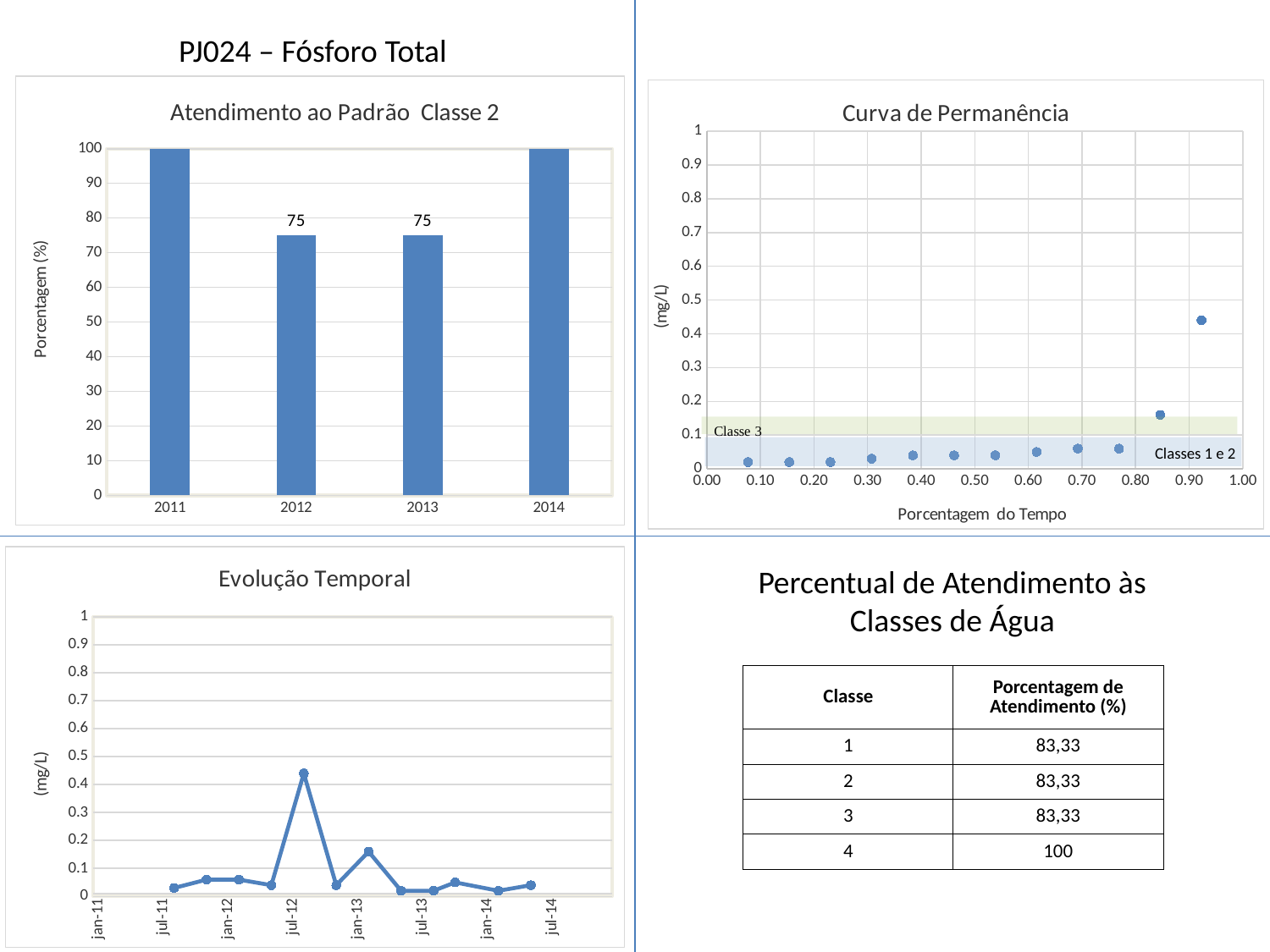
In the 'Atendimento ao Padrão Classe 2' chart, how many years are shown on the x axis? 4 In the 'Curva de Permanência' chart, is the highest plotted value greater or less than 0.4 mg/L? greater In the 'Atendimento ao Padrão Classe 2' chart, what is the difference between the values for 2014 and 2013? 25 In the 'Curva de Permanência' chart, how many data points are plotted? 12 What is the x-axis label of the 'Curva de Permanência' chart? Porcentagem do Tempo In the 'Atendimento ao Padrão Classe 2' chart, which is larger, the value for 2011 or the value for 2012? 2011 What is the y-axis label of the 'Atendimento ao Padrão Classe 2' chart? Porcentagem (%) What kind of chart is 'Atendimento ao Padrão Classe 2'? bar chart In the 'Atendimento ao Padrão Classe 2' chart, what is the value for 2013? 75 In the 'Atendimento ao Padrão Classe 2' chart, what is the value for 2011? 100 In the 'Evolução Temporal' chart, is the peak value around jul-12 greater or less than 0.3 mg/L? greater In the 'Atendimento ao Padrão Classe 2' chart, what is the value for 2012? 75